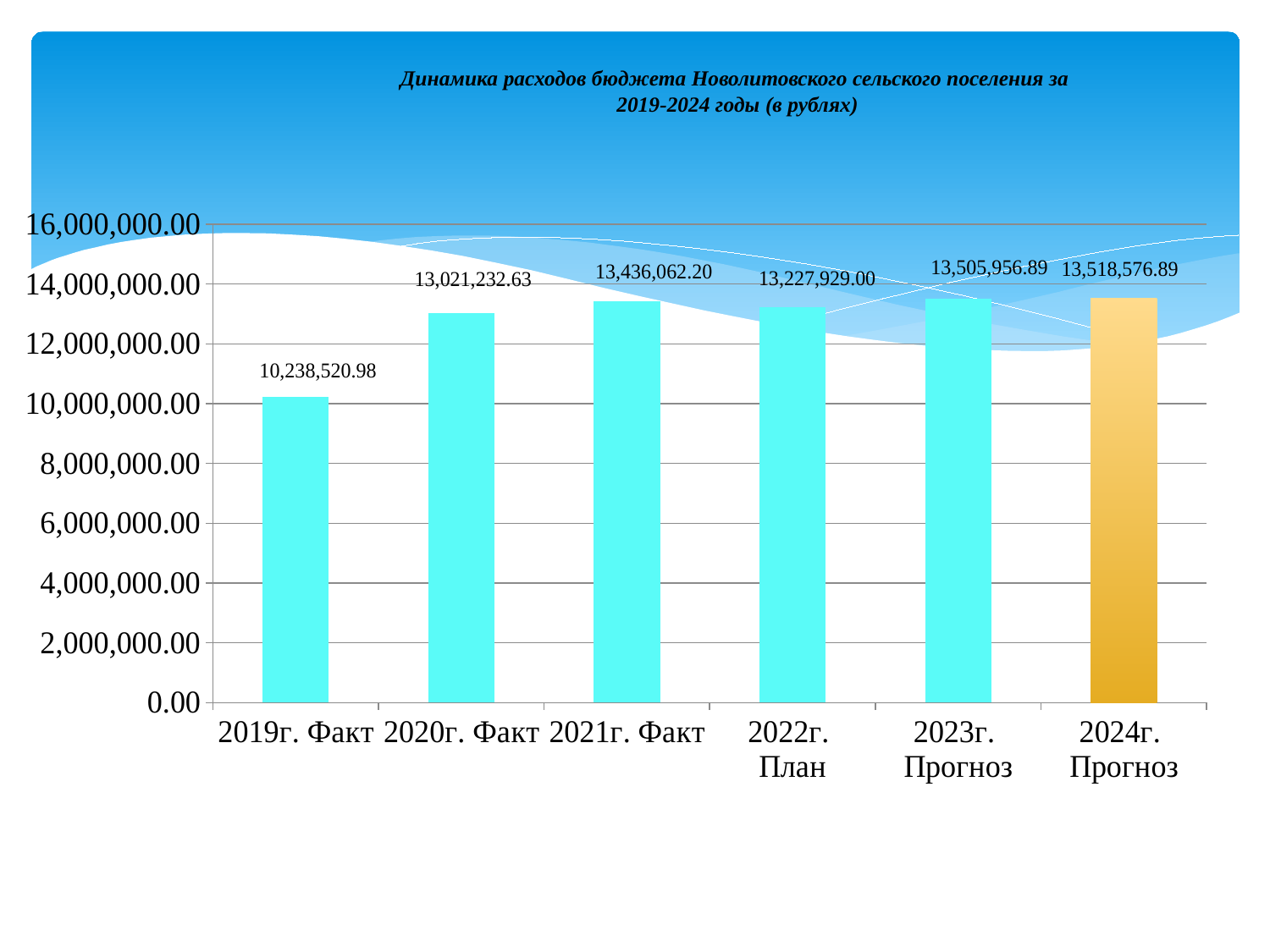
Which category has the lowest value? 2019г. Факт What is the difference between the values for 2020г. Факт and 2019г. Факт? 2,782,711.65 Does the value rise or fall from 2019г. Факт to 2020г. Факт? rise Which category has the highest value? 2024г. Прогноз Is the value for 2019г. Факт greater or less than 12,000,000.00? less What is the value for 2024г. Прогноз? 13,518,576.89 What is the value for 2022г. План? 13,227,929.00 Which is larger, the value for 2021г. Факт or the value for 2022г. План? 2021г. Факт What is the difference between the values for 2024г. Прогноз and 2023г. Прогноз? 12,620.00 How many categories are shown on the x axis? 6 What kind of chart is shown on the slide? bar chart What is the value for 2019г. Факт? 10,238,520.98